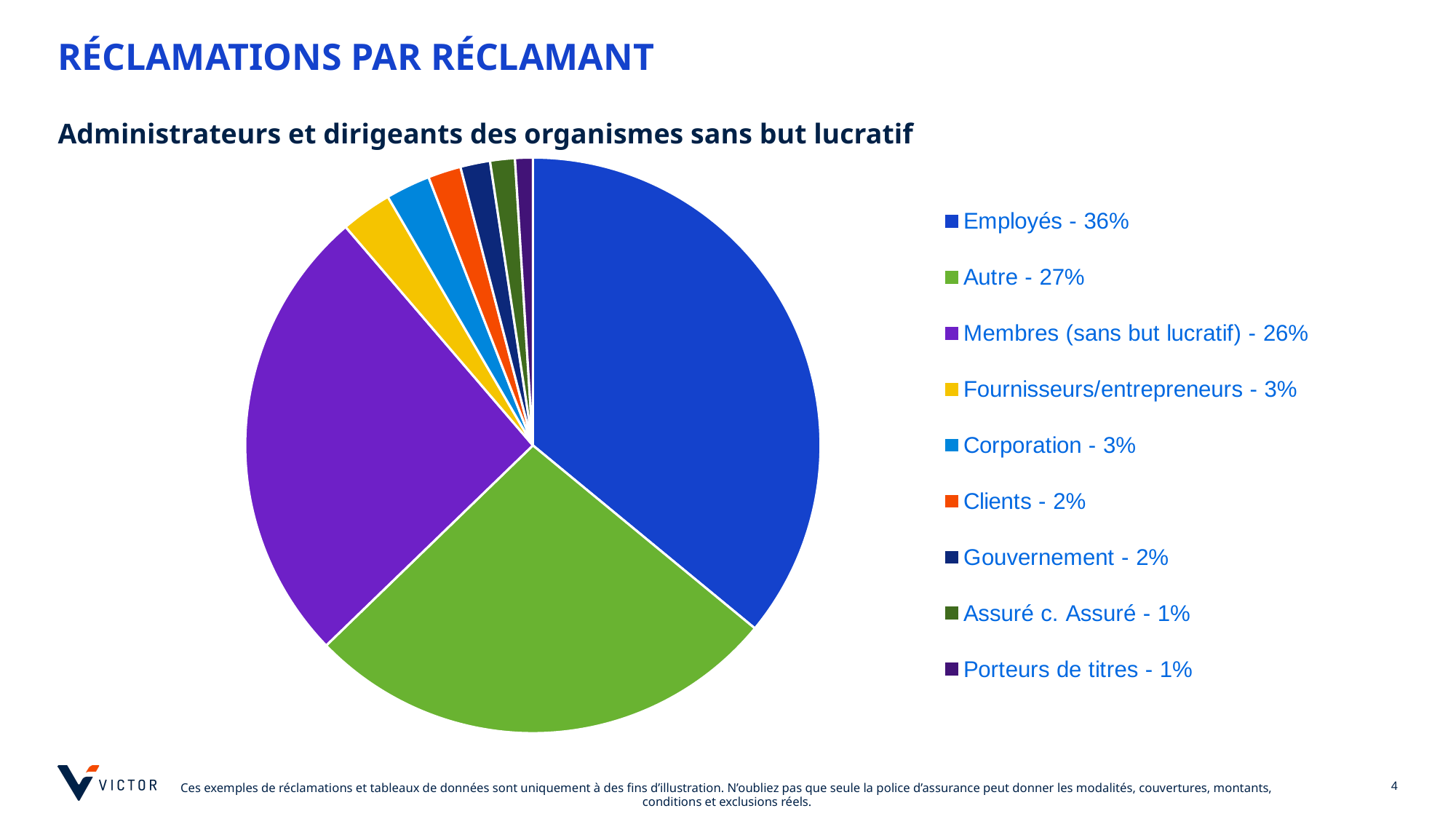
What kind of chart is shown on the slide? pie chart What colour is the slice for Fournisseurs/entrepreneurs? yellow What share of claims is attributed to Membres (sans but lucratif)? 26% What share of claims is attributed to Employés? 36% What share of claims is attributed to Porteurs de titres? 1% What share of claims is attributed to Clients? 2% Which category has the largest share of the pie? Employés What is the difference in percentage points between Employés and Autre? 9 How many categories does the legend list? 9 What is the title of the chart? Administrateurs et dirigeants des organismes sans but lucratif What is the combined share of Fournisseurs/entrepreneurs and Corporation? 6% Which is larger, the share for Autre or the share for Membres (sans but lucratif)? Autre